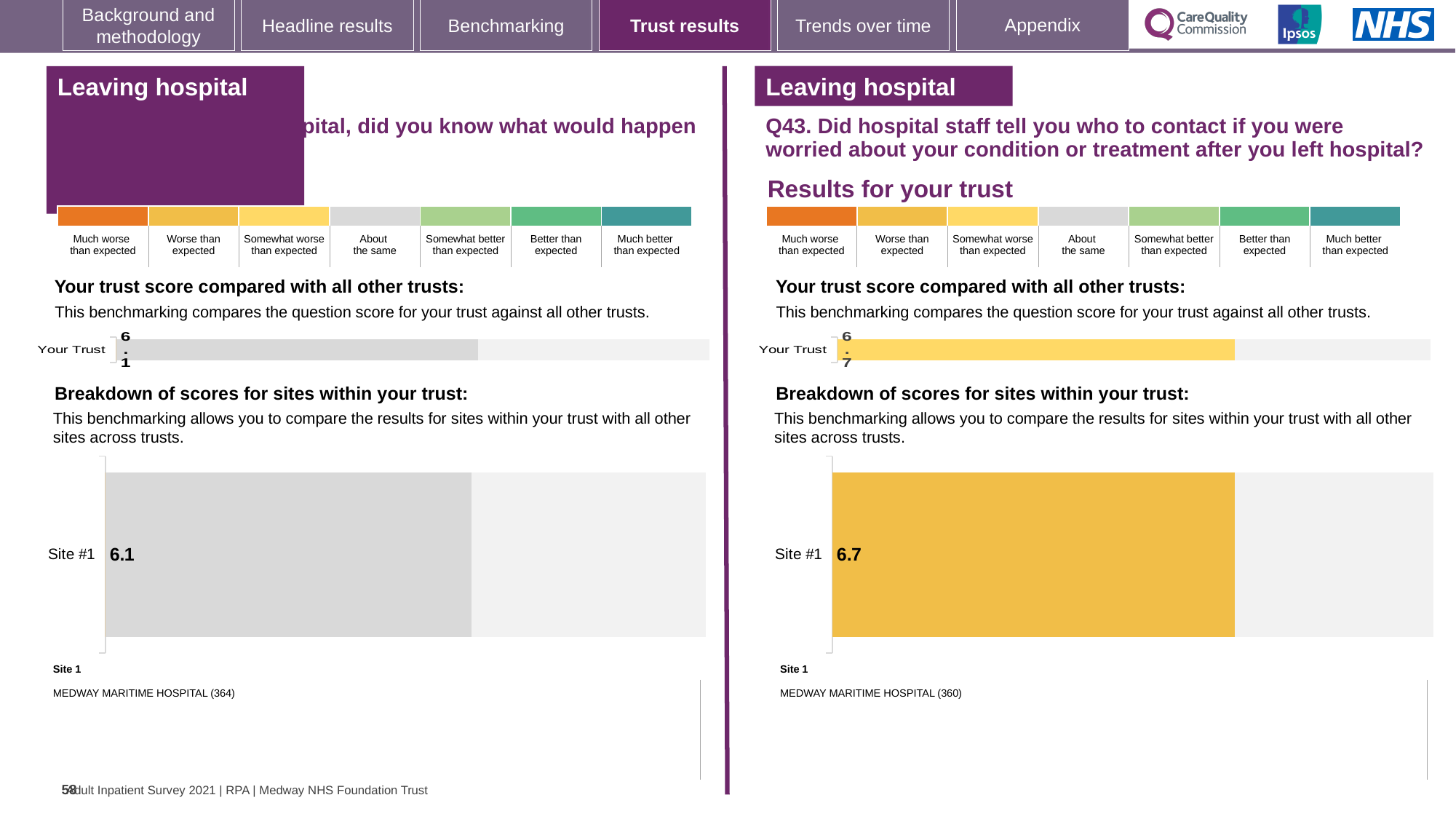
What colour is the Site #1 bar in the right-hand chart (Q43)? Yellow On the left-hand side of the slide, what is the score shown for Your Trust? 6.1 How many sites are shown in the right-hand 'Breakdown of scores for sites within your trust' chart (Q43)? 1 On the right-hand side (Q43), what is the score shown for Your Trust? 6.7 What type of chart is used to show the Site #1 score on the left-hand side of the slide? Bar chart In the right-hand 'Breakdown of scores for sites within your trust' chart (Q43), what is the score for Site #1? 6.7 In the left-hand 'Breakdown of scores for sites within your trust' chart, what is the score for Site #1? 6.1 Which site name is listed under Site 1 on the right-hand side (Q43)? MEDWAY MARITIME HOSPITAL (360) Which is larger: the Site #1 score in the left-hand chart or the Site #1 score in the right-hand chart (Q43)? The right-hand chart (Q43) What is the difference between the Site #1 score in the right-hand chart (Q43) and the Site #1 score in the left-hand chart? 0.6 Is the Your Trust score on the right-hand side (Q43) greater or less than the Your Trust score on the left-hand side? greater